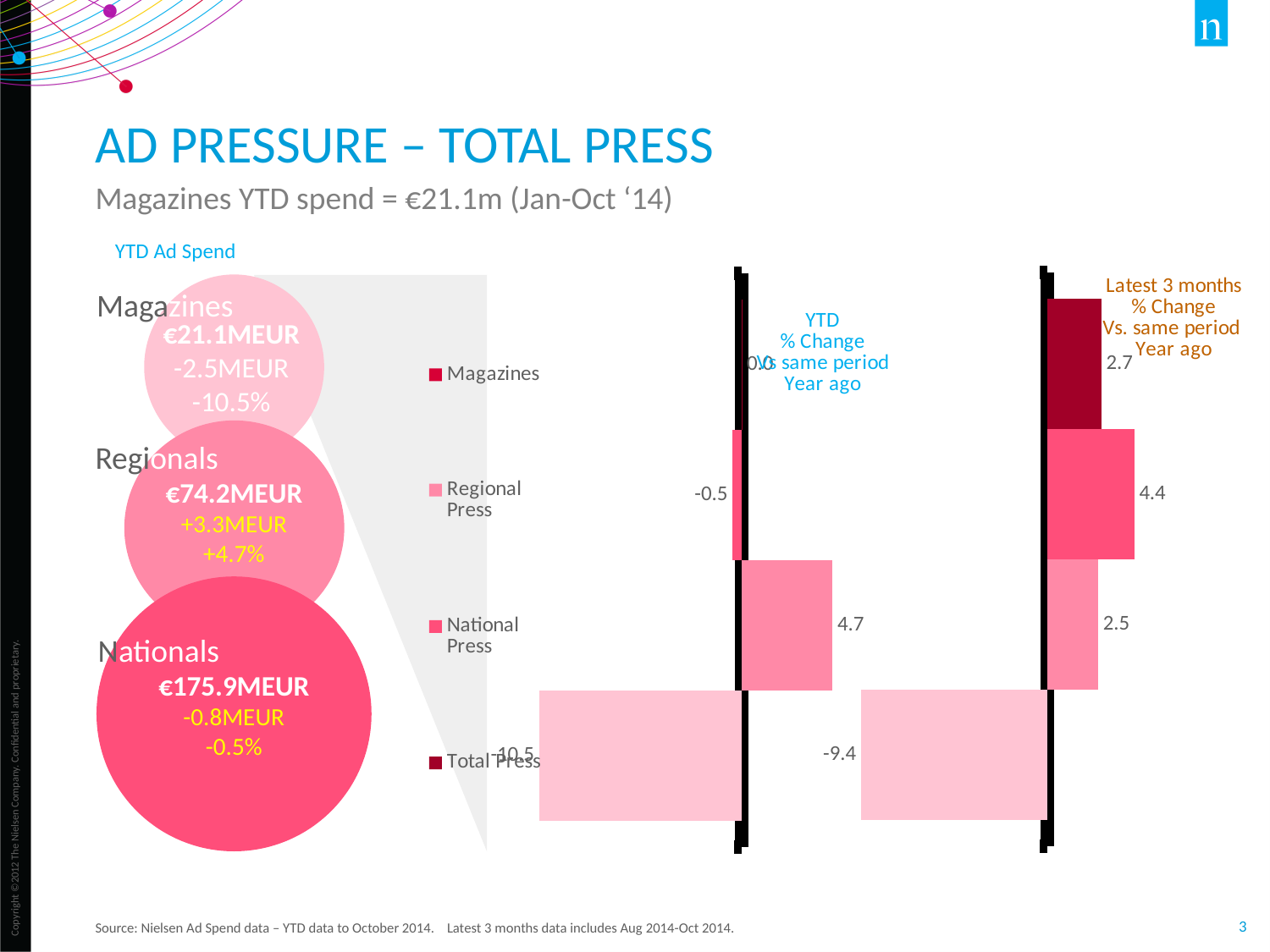
In the YTD Ad Spend bubble chart, what is the percentage change shown for Nationals? -0.5% In the 'Latest 3 months % Change Vs. same period Year ago' chart, what is the lowest value shown? -9.4 In the YTD Ad Spend bubble chart, what is the change in MEUR shown for Magazines? -2.5MEUR In the 'YTD % Change Vs same period Year ago' chart, what is the lowest value shown? -10.5 What kind of chart is the 'Latest 3 months % Change Vs. same period Year ago' chart? Bar chart In the YTD Ad Spend bubble chart, what is the percentage change shown for Regionals? +4.7% How many categories are shown in the YTD Ad Spend bubble chart? 3 In the YTD Ad Spend bubble chart, how much larger is the Nationals YTD spend than the Regionals YTD spend, in MEUR? 101.7MEUR In the YTD Ad Spend bubble chart, which category has the smallest YTD spend? Magazines In the YTD Ad Spend bubble chart, what is the YTD spend for Nationals? €175.9MEUR In the 'YTD % Change Vs same period Year ago' chart, what is the highest value shown? 4.7 In the YTD Ad Spend bubble chart, which category has the largest YTD spend? Nationals